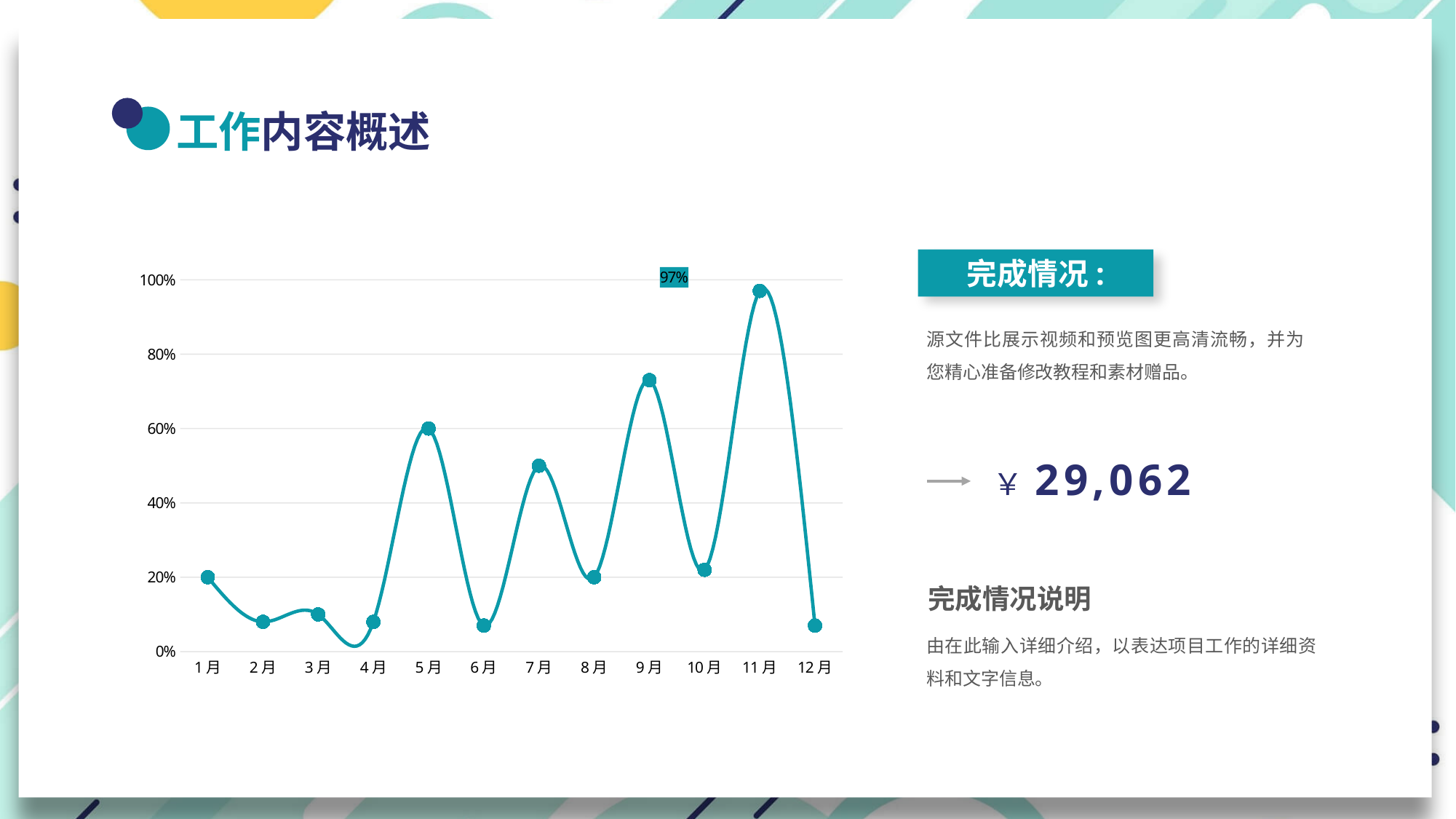
How many months are plotted along the x axis of the chart? 12 Which month has the highest value in the chart? 11月 What kind of chart is shown on the slide? line chart What is the highest value shown on the chart's y axis? 100% Is the value for 5月 greater or less than 40%? greater Which is larger, the value for 9月 or the value for 5月? 9月 Is the value for 9月 greater or less than 60%? greater Which is larger, the value for 5月 or the value for 7月? 5月 Does the line rise or fall from 11月 to 12月? fall Is the value for 6月 greater or less than 20%? less Does the line rise or fall from 8月 to 9月? rise